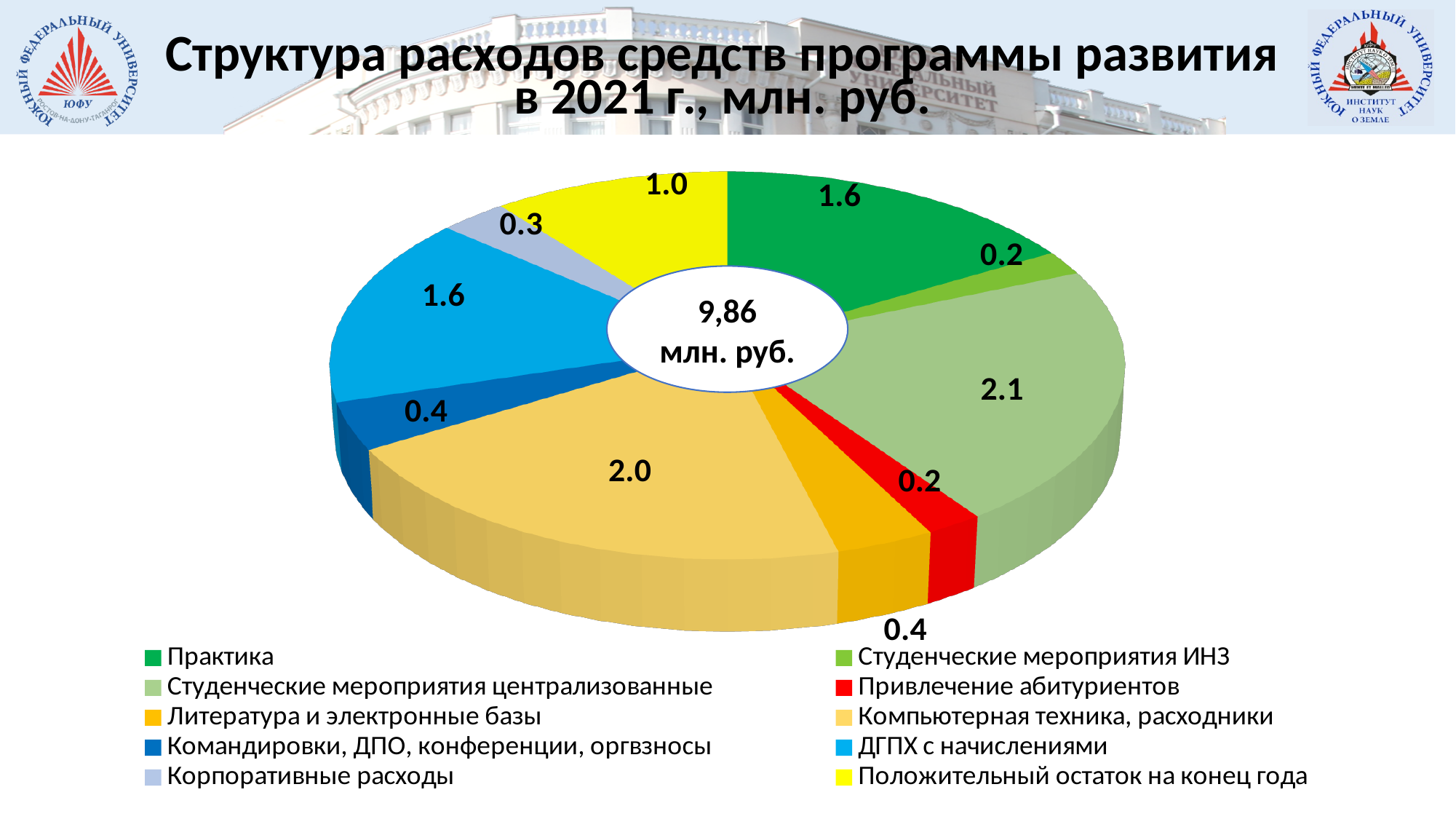
Which is larger: ДГПХ с начислениями or Командировки, ДПО, конференции, оргвзносы? ДГПХ с начислениями Which category has the largest value? Студенческие мероприятия централизованные What total amount is shown in the centre of the pie chart? 9,86 млн. руб. What is the value for Положительный остаток на конец года? 1.0 What is the value for Корпоративные расходы? 0.3 What is the difference between Студенческие мероприятия централизованные and Практика? 0.5 What kind of chart is shown on the slide? Pie chart How many categories does the pie chart have? 10 Which is larger: Привлечение абитуриентов or Литература и электронные базы? Литература и электронные базы What is the value for Компьютерная техника, расходники? 2.0 What is the value for Литература и электронные базы? 0.4 What is the value for Практика? 1.6